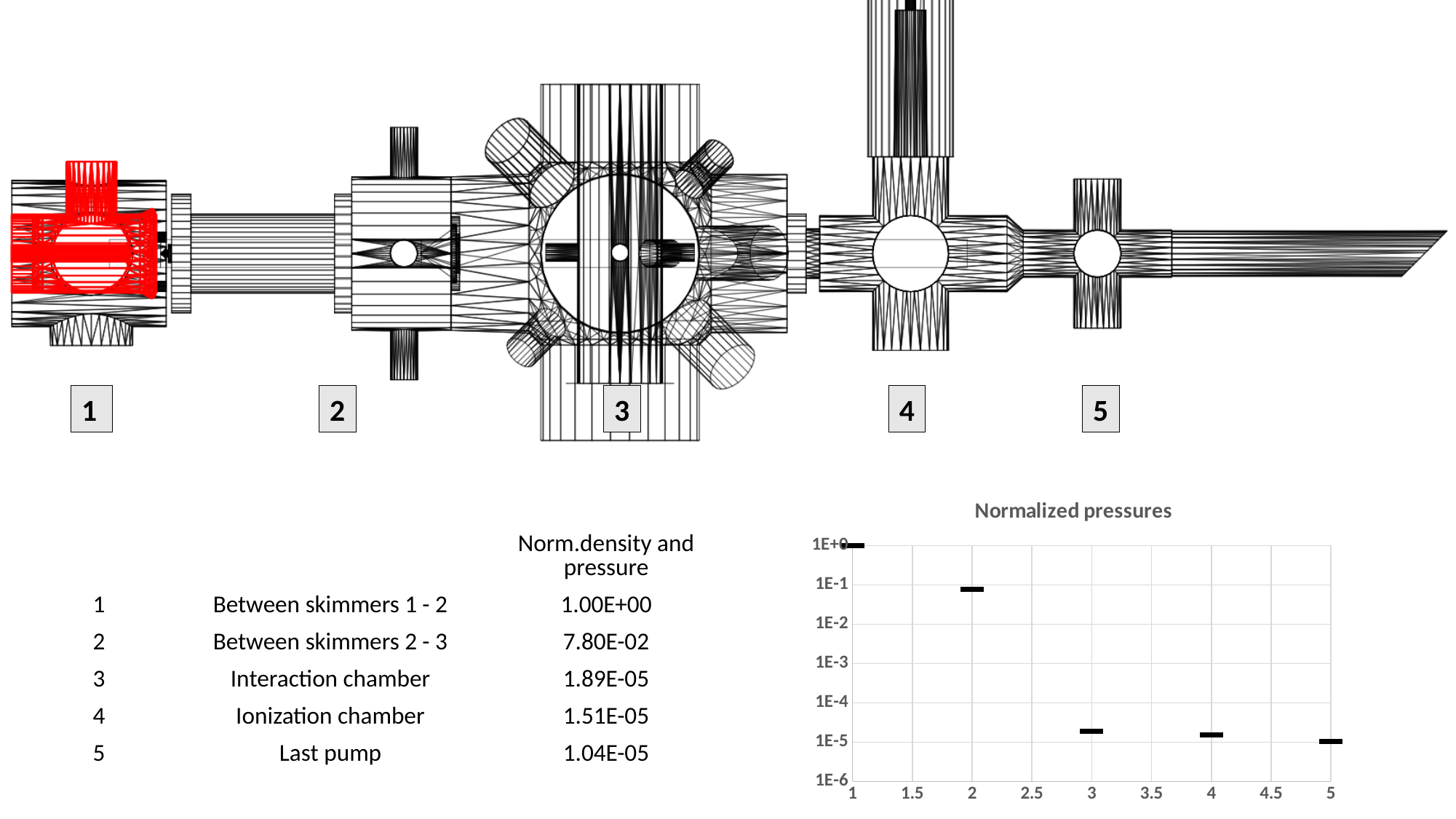
In the "Normalized pressures" chart, is the value at x = 2 greater or less than 1E-2? greater According to the table on the slide, what is the normalized density and pressure for Between skimmers 2 - 3 (point 2)? 7.80E-02 In the "Normalized pressures" chart, do the values rise or fall as x increases from 1 to 5? fall What type of chart is shown under the title "Normalized pressures"? scatter plot How many data points are plotted in the "Normalized pressures" chart? 5 In the "Normalized pressures" chart, at which x value is the plotted pressure lowest? 5 In the "Normalized pressures" chart, is the value at x = 3 greater or less than 1E-4? less In the "Normalized pressures" chart, which has the larger value: the point at x = 2 or the point at x = 3? x = 2 According to the table on the slide, what is the normalized density and pressure for the Interaction chamber (point 3)? 1.89E-05 In the "Normalized pressures" chart, is the value at x = 4 greater or less than 1E-5? greater What is the title of the chart on the slide? Normalized pressures In the "Normalized pressures" chart, at which x value is the plotted pressure highest? 1